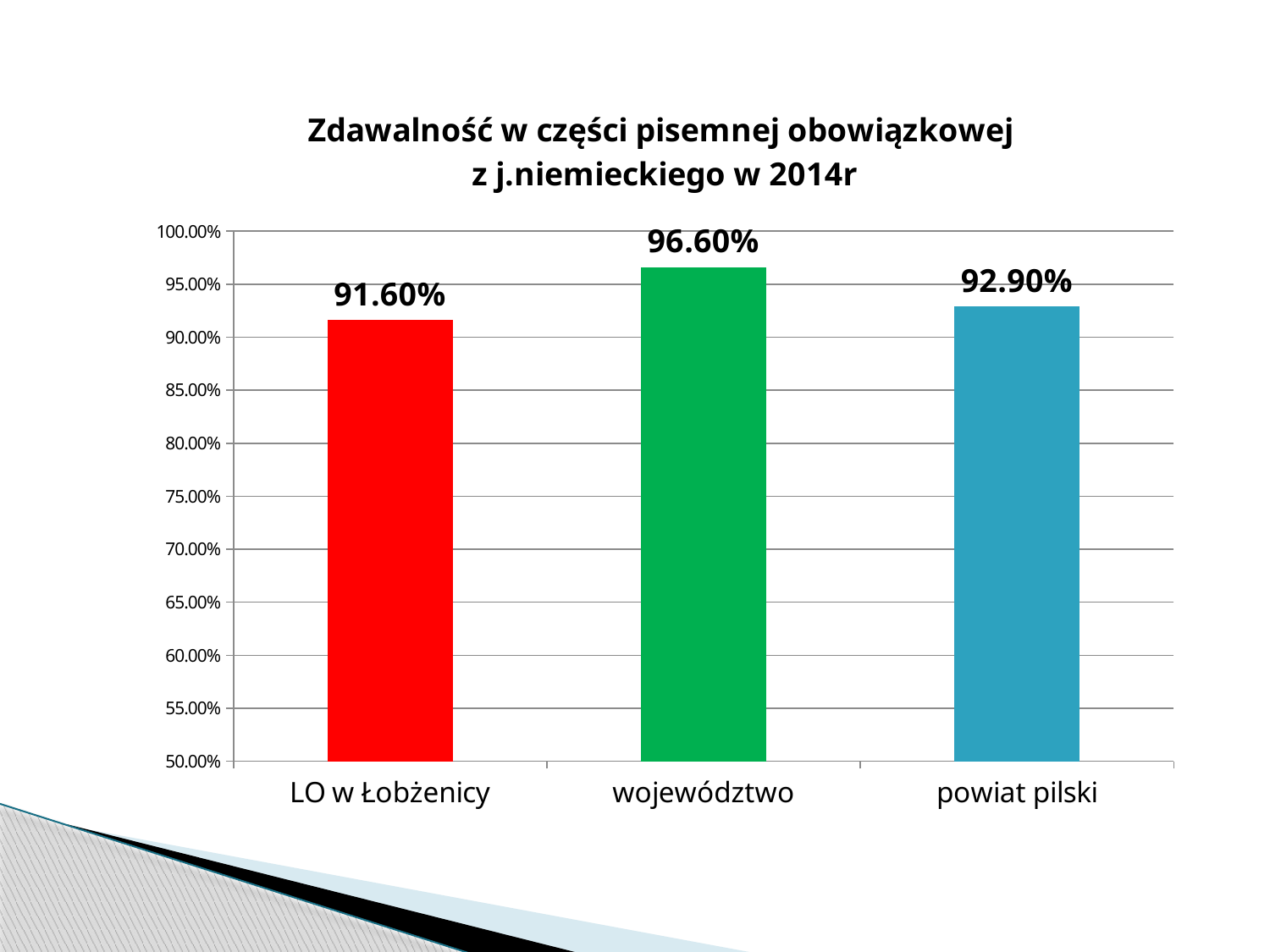
What is the value for powiat pilski? 92.90% Which category has the highest value? województwo Is the value for województwo greater or less than 95.00%? greater What is the value for LO w Łobżenicy? 91.60% How many categories are shown on the chart? 3 What is the value for województwo? 96.60% What kind of chart is shown on the slide? bar chart What is the difference between the values for województwo and LO w Łobżenicy? 5.00% What is the title of the chart? Zdawalność w części pisemnej obowiązkowej z j.niemieckiego w 2014r Which category has the lowest value? LO w Łobżenicy What is the difference between the values for powiat pilski and LO w Łobżenicy? 1.30% Which is larger, the value for powiat pilski or the value for LO w Łobżenicy? powiat pilski